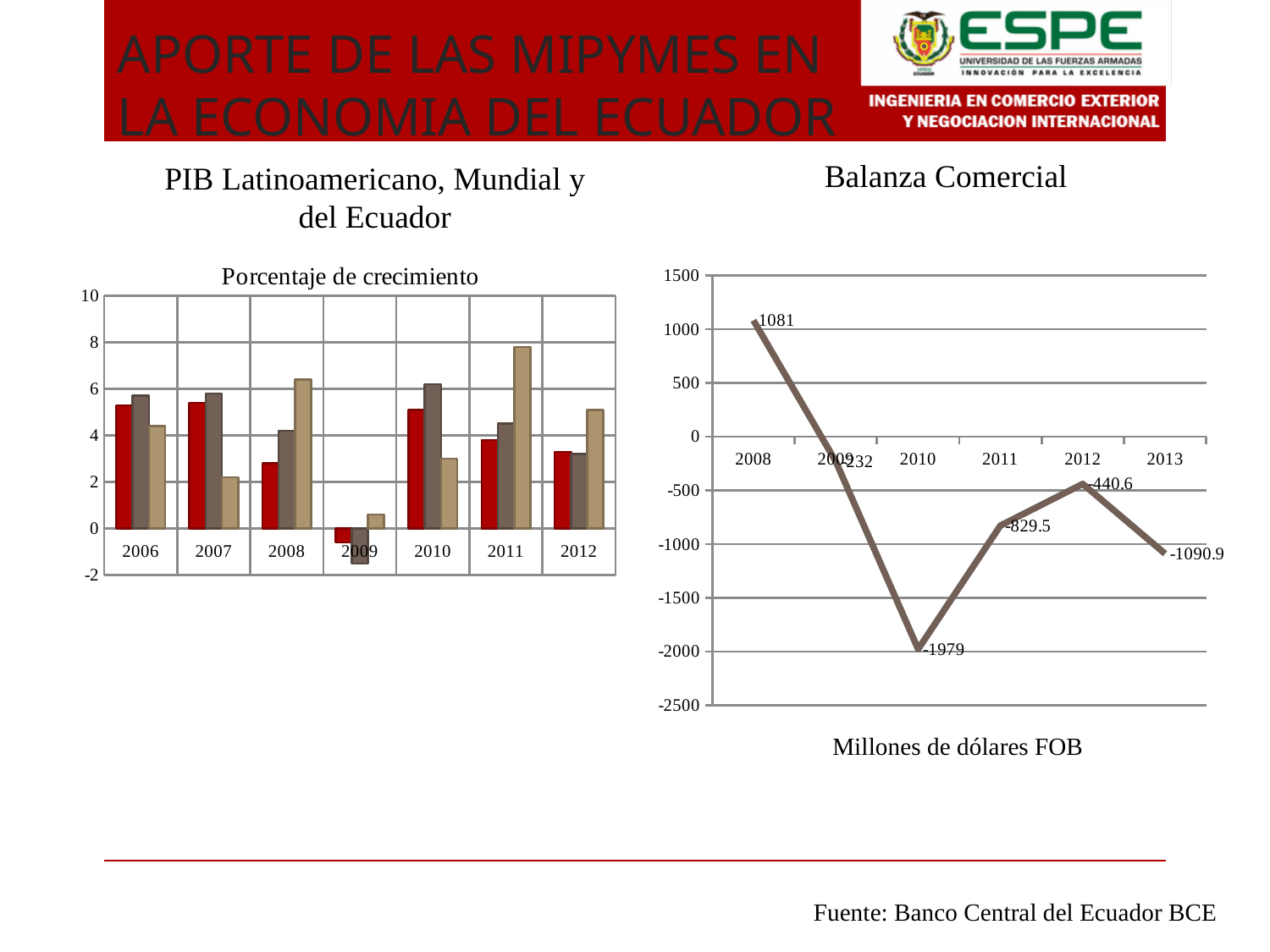
What unit is stated below the Balanza Comercial chart? Millones de dólares FOB In the Balanza Comercial chart, what is the difference between the values for 2012 and 2013? 650.3 In the Balanza Comercial chart, which year has the highest value? 2008 What kind of chart is the Balanza Comercial chart? Line chart In the Balanza Comercial chart, how many years are plotted? 6 What kind of chart is the Porcentaje de crecimiento chart on the left? Bar chart In the Balanza Comercial chart, what is the value for 2013? -1090.9 In the Balanza Comercial chart, what is the value for 2010? -1979 In the Balanza Comercial chart, what is the value for 2008? 1081 In the Balanza Comercial chart, what is the value for 2011? -829.5 In the Porcentaje de crecimiento chart on the left, is the tan bar for 2011 greater or less than 6? greater In the Balanza Comercial chart, which year has the lowest value? 2010